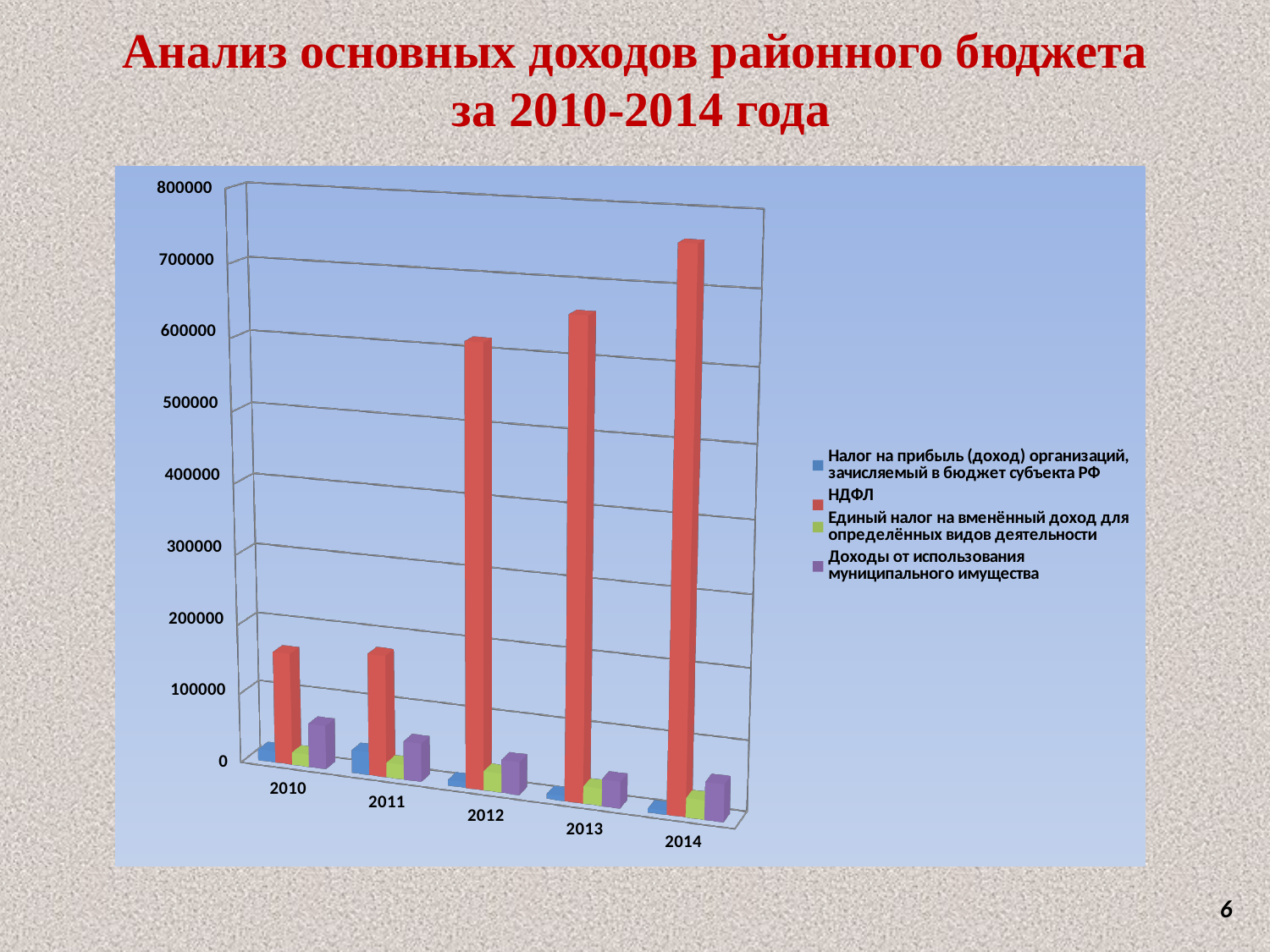
Does the series 'Доходы от использования муниципального имущества' rise or fall from 2010 to 2014? fall Does the НДФЛ series generally rise or fall from 2010 to 2014? rise Is the НДФЛ value for 2013 greater or less than 600000? greater How many series does the chart legend list? 4 Is the НДФЛ value for 2014 greater or less than 700000? greater What colour represents the НДФЛ series in the chart? red In 2010, which is larger: 'Единый налог на вменённый доход для определённых видов деятельности' or 'Доходы от использования муниципального имущества'? Доходы от использования муниципального имущества What kind of chart is shown on the slide? bar chart In which year is the НДФЛ value highest? 2014 How many years are shown on the x axis of the chart? 5 Is the НДФЛ value for 2010 greater or less than 200000? less Which is larger, the НДФЛ value for 2012 or for 2014? 2014